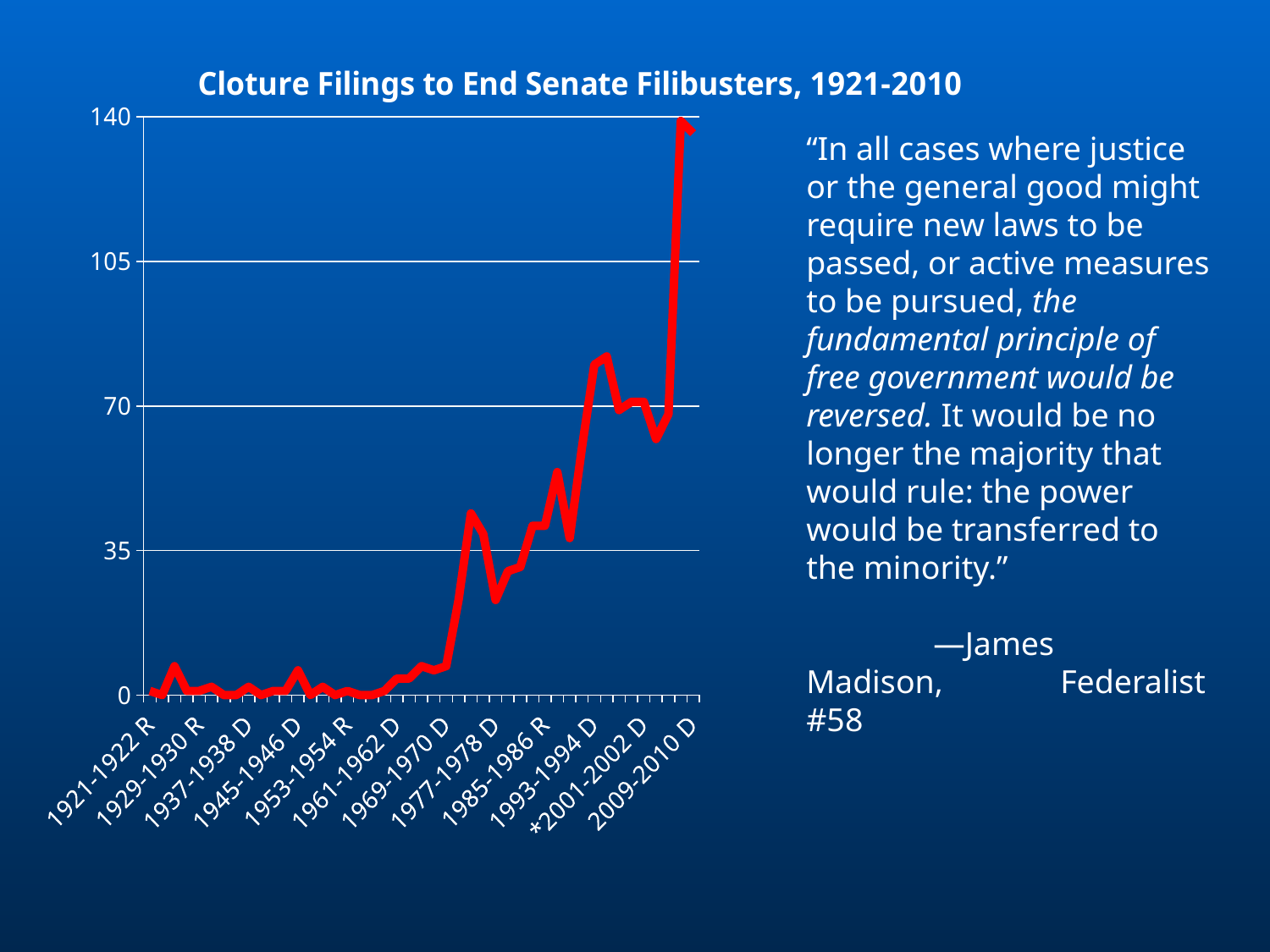
Is the value for 1969-1970 D greater or less than 35? less What kind of chart is shown on the slide? line chart Is the value for 1921-1922 R greater or less than 35? less Which labelled period on the x axis has the highest number of cloture filings? 2009-2010 D Overall, do cloture filings rise or fall from 1921-1922 to 2009-2010? rise How many period labels are printed along the x axis? 12 Which has the larger value, 2009-2010 D or 1921-1922 R? 2009-2010 D Is the value for 1961-1962 D greater or less than 35? less What colour is the line plotted on the chart? red What is the title of the chart? Cloture Filings to End Senate Filibusters, 1921-2010 Which has the larger value, 1993-1994 D or 1929-1930 R? 1993-1994 D